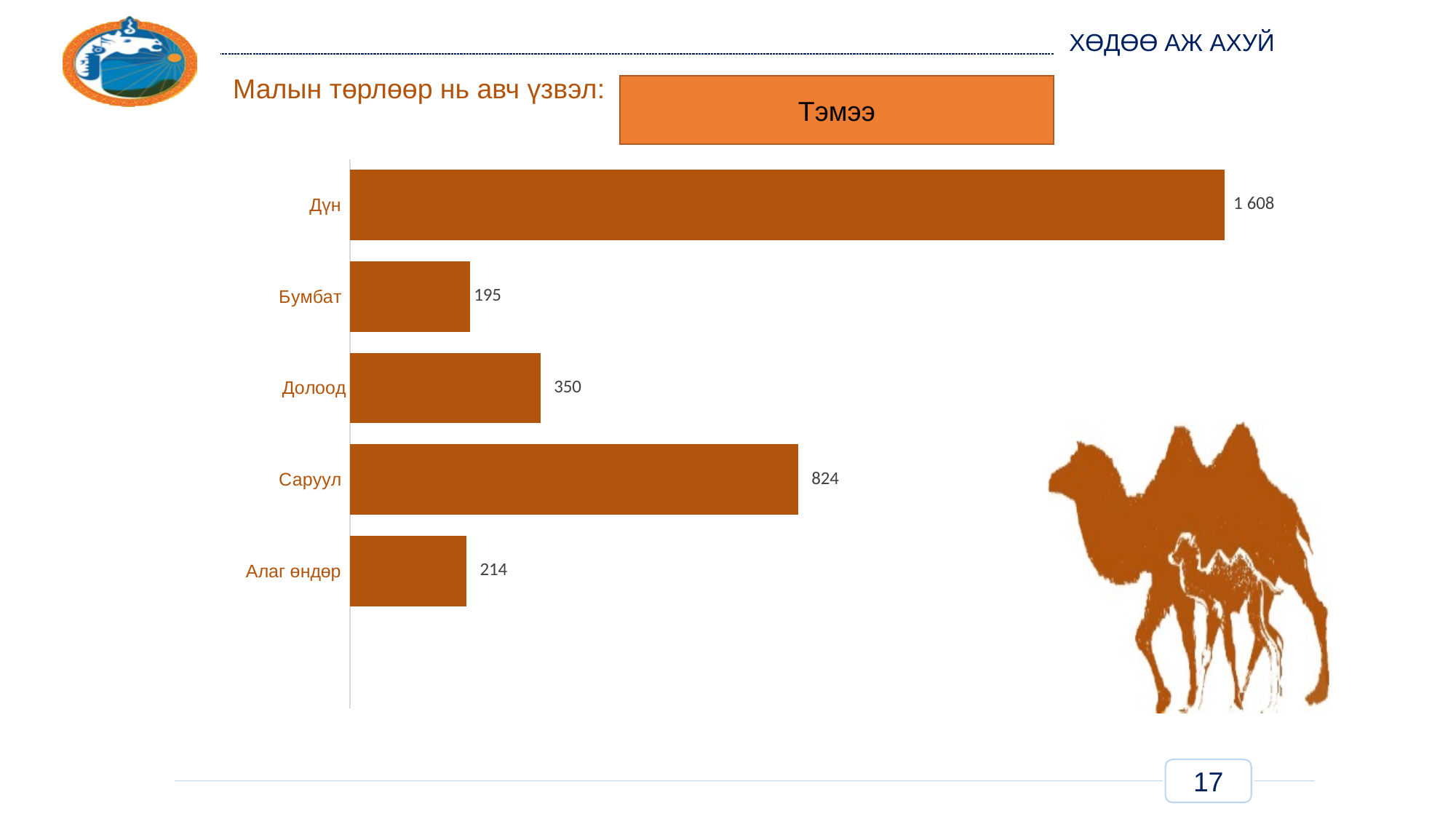
What is the difference between the values for Саруул and Долоод? 474 Which is larger, the value for Алаг өндөр or the value for Бумбат? Алаг өндөр What kind of chart is shown on the slide? Bar chart Which category has the lowest value? Бумбат What is the value for Алаг өндөр? 214 What is the value for Дүн? 1 608 How many categories are shown in the chart? 5 What is the value for Долоод? 350 Which category has the highest value? Дүн What is the value for Бумбат? 195 What is the value for Саруул? 824 What is the title shown in the orange box above the chart? Тэмээ